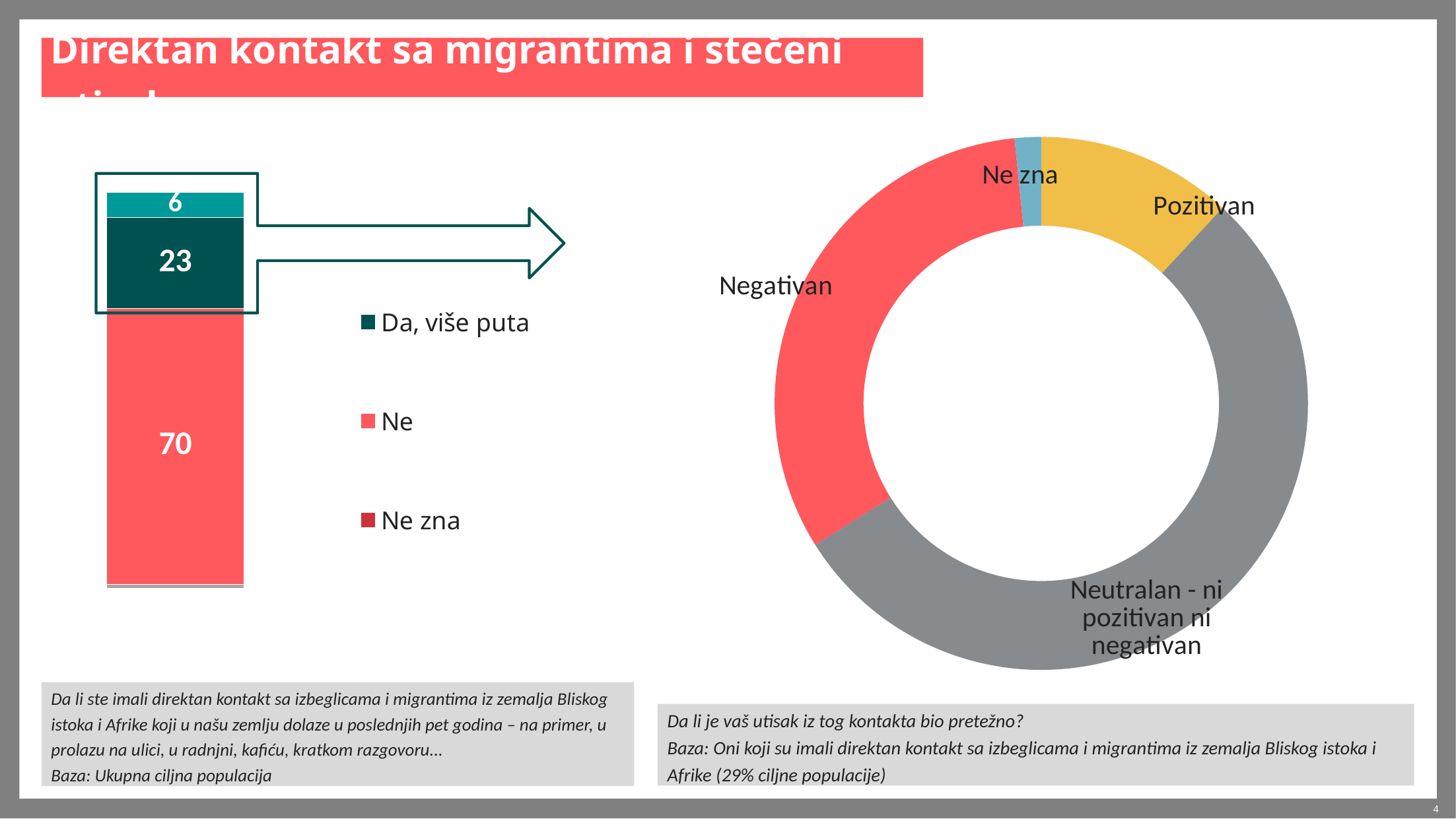
In the bar chart on the left, what is the value for "Ne"? 70 How many slices does the doughnut chart on the right have? 4 In the bar chart on the left, how many entries does the legend list? 3 In the doughnut chart on the right, which category has the smallest slice? Ne zna In the bar chart on the left, which legend category has the largest value? Ne In the bar chart on the left, which is larger: the value for "Ne" or for "Da, više puta"? Ne In the bar chart on the left, what is the value for "Da, više puta"? 23 What kind of chart is shown on the left of the slide? Stacked bar chart In the bar chart on the left, what is the difference between the values for "Ne" and "Da, više puta"? 47 In the doughnut chart on the right, which category has the largest slice? Neutralan - ni pozitivan ni negativan What kind of chart is shown on the right of the slide? Doughnut (pie) chart In the doughnut chart on the right, which slice is larger: "Negativan" or "Pozitivan"? Negativan